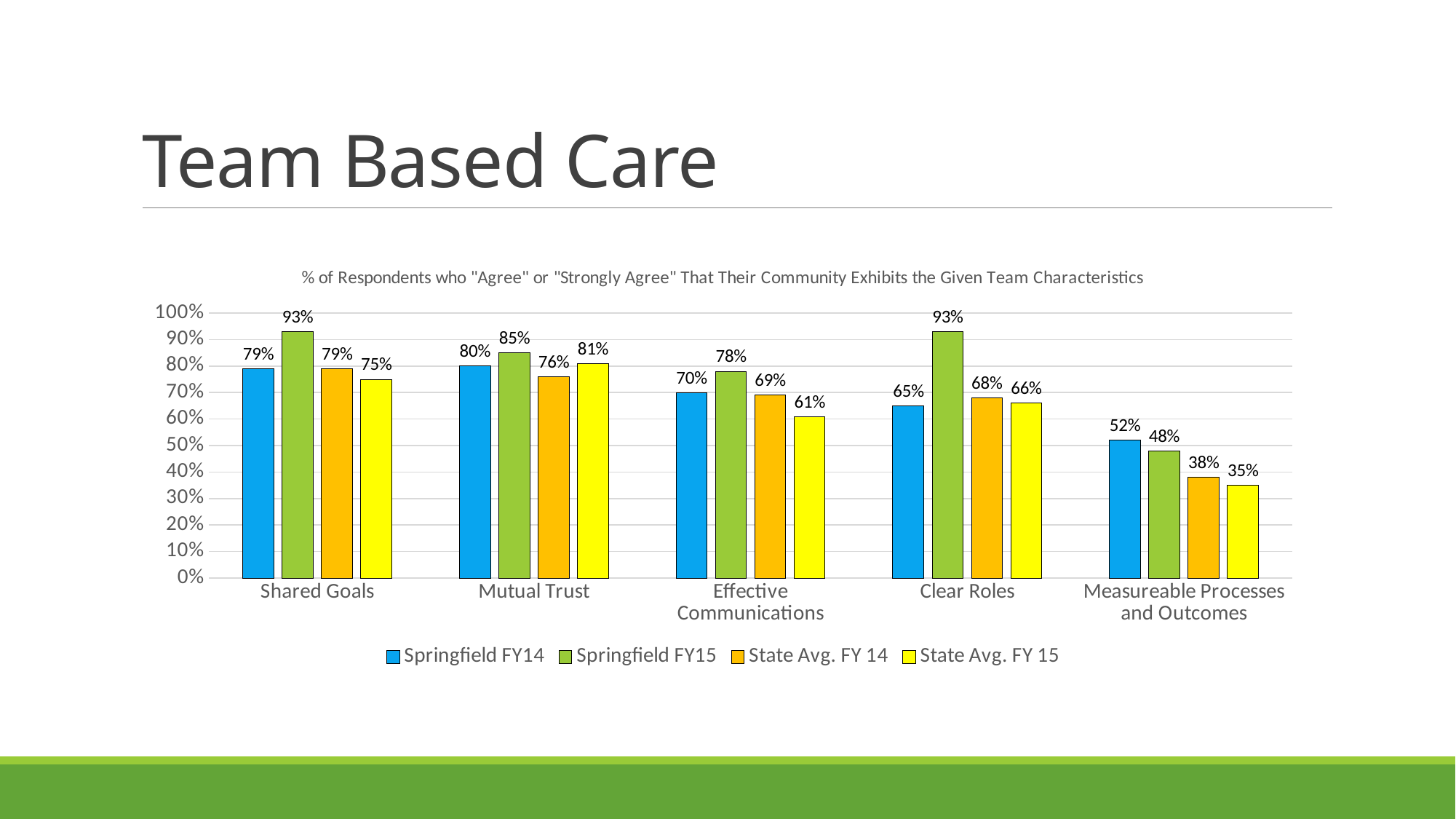
What is the difference between the Springfield FY15 and Springfield FY14 values for Clear Roles? 28% How many categories are shown on the x axis? 5 Which category has the lowest Springfield FY15 value? Measureable Processes and Outcomes What kind of chart is shown on the slide? Bar chart Which is larger for Mutual Trust: State Avg. FY 14 or State Avg. FY 15? State Avg. FY 15 Which category has the highest State Avg. FY 14 value? Shared Goals Which colour represents Springfield FY14 in the legend? Blue What is the Springfield FY14 value for Measureable Processes and Outcomes? 52% What is the State Avg. FY 15 value for Effective Communications? 61% How many series does the legend list? 4 What is the difference between the State Avg. FY 14 and State Avg. FY 15 values for Measureable Processes and Outcomes? 3% What is the Springfield FY15 value for Shared Goals? 93%